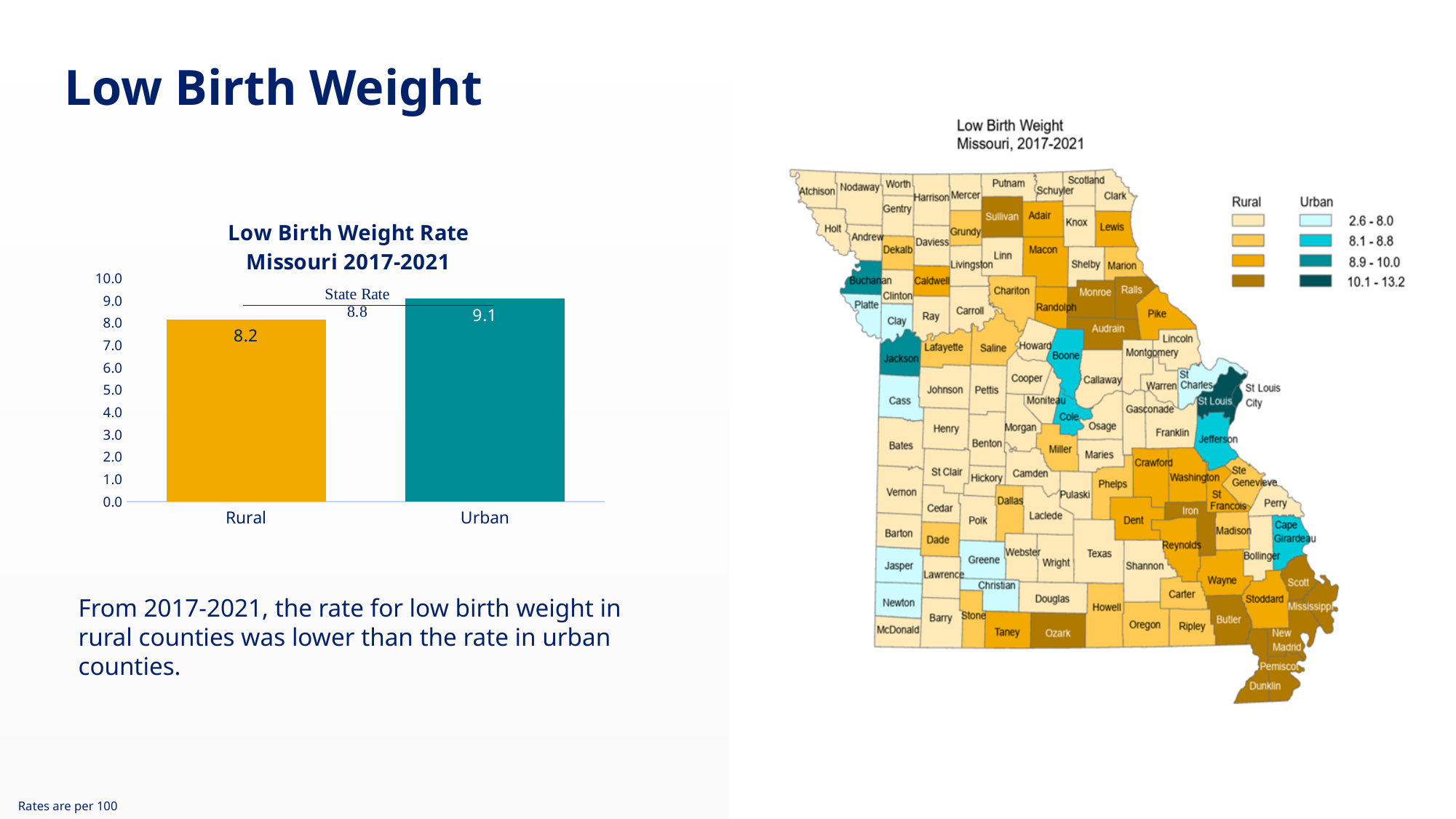
In the bar chart, is the value for Urban greater or less than 9.0? greater In the bar chart, which category has the higher low birth weight rate? Urban In the bar chart, what is the low birth weight rate for Urban counties? 9.1 In the bar chart, which category has the lower low birth weight rate? Rural In the bar chart, what is the low birth weight rate for Rural counties? 8.2 In the bar chart, what is the State Rate shown by the reference line? 8.8 In the bar chart, what is the difference between the Urban and Rural low birth weight rates? 0.9 In the bar chart, is the Rural rate greater or less than the State Rate? less What is the title of the bar chart? Low Birth Weight Rate Missouri 2017-2021 How many categories are shown in the bar chart? 2 What kind of chart is the chart on the left of the slide? bar chart In the bar chart, what is the maximum value shown on the y axis? 10.0